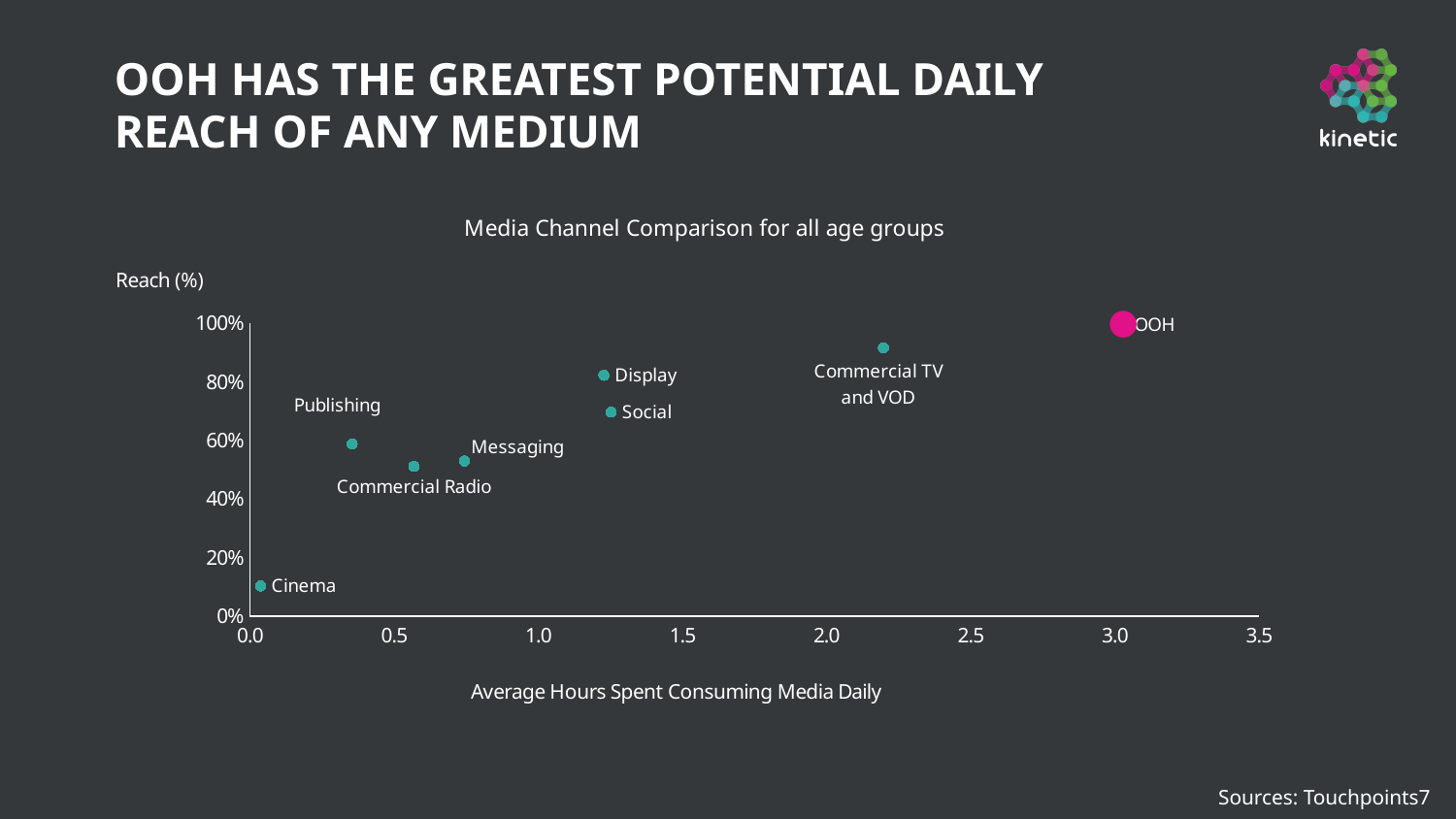
Is the reach for Publishing greater or less than 80%? less Which media channel has the lowest reach? Cinema Which has the higher reach, Display or Social? Display Which has the higher reach, Commercial TV and VOD or Display? Commercial TV and VOD Which media channel has the highest average hours spent consuming media daily? OOH What kind of chart is shown on the slide? Scatter chart What is the title of the chart? Media Channel Comparison for all age groups Is the reach for OOH greater or less than 80%? greater Is the average hours spent daily for Commercial TV and VOD greater or less than 2.0? greater How many media channels are plotted on the chart? 8 Which media channel has the highest reach? OOH